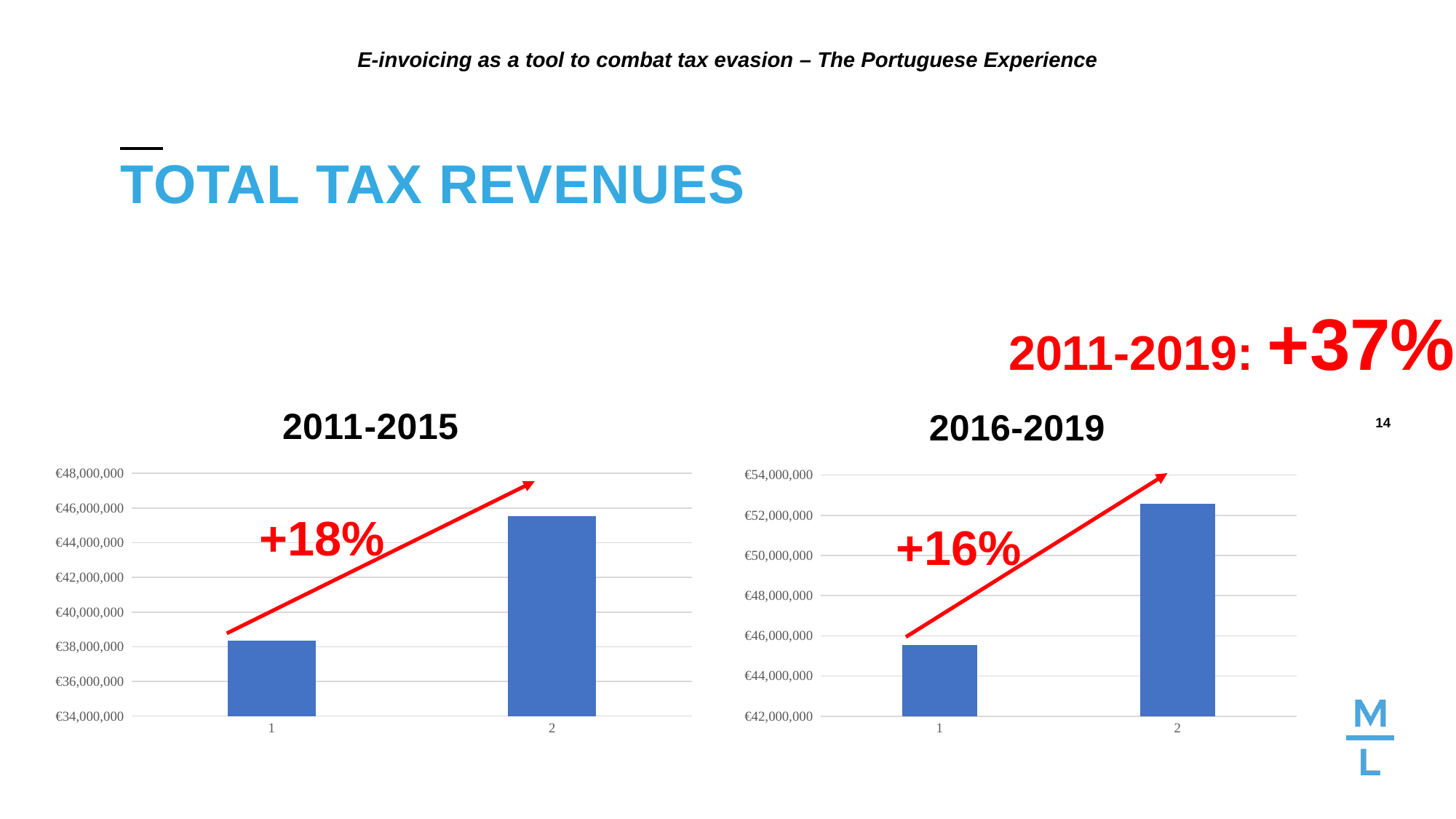
In the 2011-2015 chart, is the value for category 1 greater or less than €40,000,000? less In the 2016-2019 chart, which category has the lowest value? 1 How many bars are plotted in the 2011-2015 chart? 2 In the 2016-2019 chart, is the value for category 1 greater or less than €48,000,000? less In the 2016-2019 chart, do the values rise or fall from category 1 to category 2? rise What kind of chart is the 2011-2015 chart? bar chart In the 2011-2015 chart, which is larger, the value for category 1 or category 2? 2 What overall percentage change is shown for 2011-2019 on the slide? +37% In the 2011-2015 chart, is the value for category 2 greater or less than €44,000,000? greater In the 2011-2015 chart, which category has the highest value? 2 What percentage change is annotated on the 2011-2015 chart? +18%